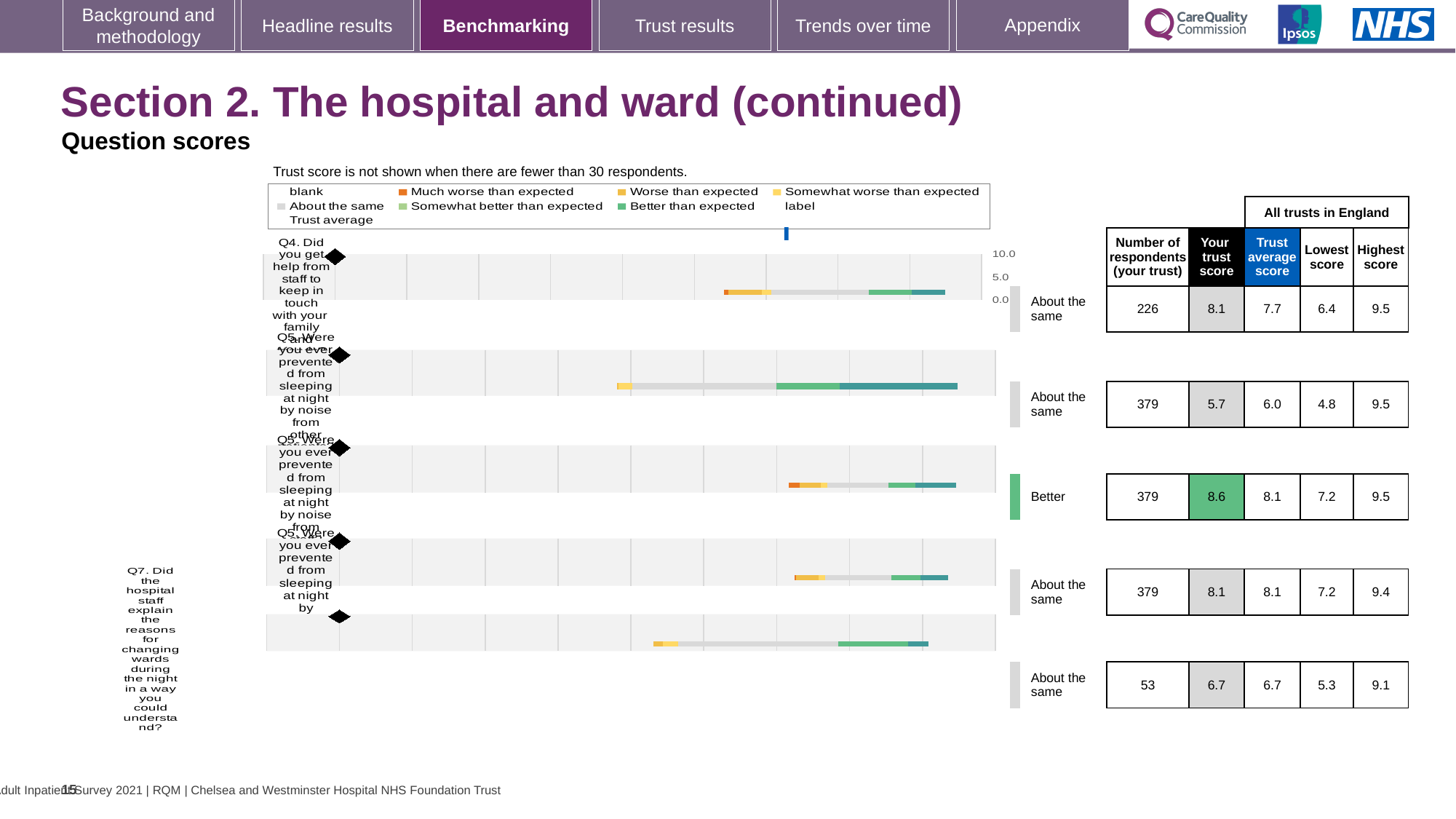
For Q4, what is the difference between your trust score (8.1) and the trust average score (7.7)? 0.4 For Q7, what is the lowest score among all trusts in England? 5.3 Which row is rated 'Better' rather than 'About the same' in the benchmarking comparison? the third row (trust score 8.6) For Q4, which is larger: your trust score or the trust average score? your trust score For Q7 (explaining reasons for changing wards during the night), what is the highest score among all trusts in England? 9.1 For Q4 (help from staff to keep in touch with family), what is the trust score shown in the 'Your trust score' column? 8.1 What kind of chart is used to show the question scores on this slide? bar chart For Q4 (help from staff to keep in touch with family), what is the number of respondents for your trust? 226 How many question rows (bars) are shown in the benchmarking chart? 5 For Q7 (explaining reasons for changing wards during the night), what is the number of respondents for your trust? 53 What is the highest tick value shown on the axis above the first bar? 10.0 According to the note above the chart, below how many respondents is the trust score not shown? 30